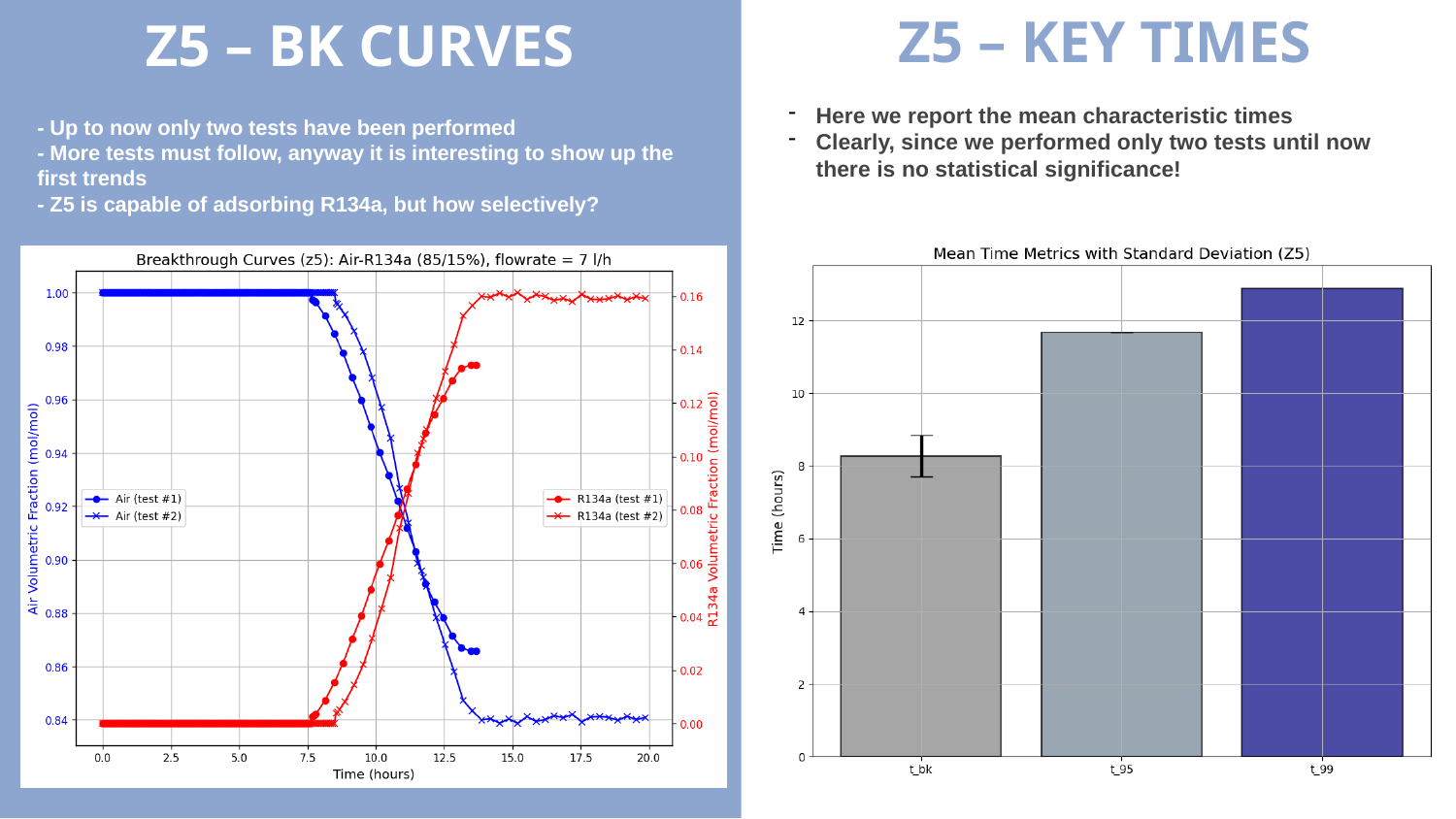
In the chart titled "Mean Time Metrics with Standard Deviation (Z5)", do the bar values rise or fall from left to right? rise What kind of chart is the one titled "Breakthrough Curves (z5): Air-R134a (85/15%), flowrate = 7 l/h"? line chart What kind of chart is the one titled "Mean Time Metrics with Standard Deviation (Z5)"? bar chart In the chart titled "Mean Time Metrics with Standard Deviation (Z5)", how many bars are plotted? 3 In the chart titled "Mean Time Metrics with Standard Deviation (Z5)", what is the label of the y axis? Time (hours) In the chart titled "Mean Time Metrics with Standard Deviation (Z5)", is the value for t_95 greater or less than 12? less In the chart titled "Breakthrough Curves (z5): Air-R134a (85/15%), flowrate = 7 l/h", how many series do the legends list in total? 4 In the chart titled "Mean Time Metrics with Standard Deviation (Z5)", is the value for t_bk greater or less than 8? greater In the chart titled "Mean Time Metrics with Standard Deviation (Z5)", which category has the lowest value? t_bk In the chart titled "Mean Time Metrics with Standard Deviation (Z5)", which is larger, t_95 or t_bk? t_95 In the chart titled "Mean Time Metrics with Standard Deviation (Z5)", which category has the highest value? t_99 In the chart titled "Mean Time Metrics with Standard Deviation (Z5)", is the value for t_99 greater or less than 12? greater